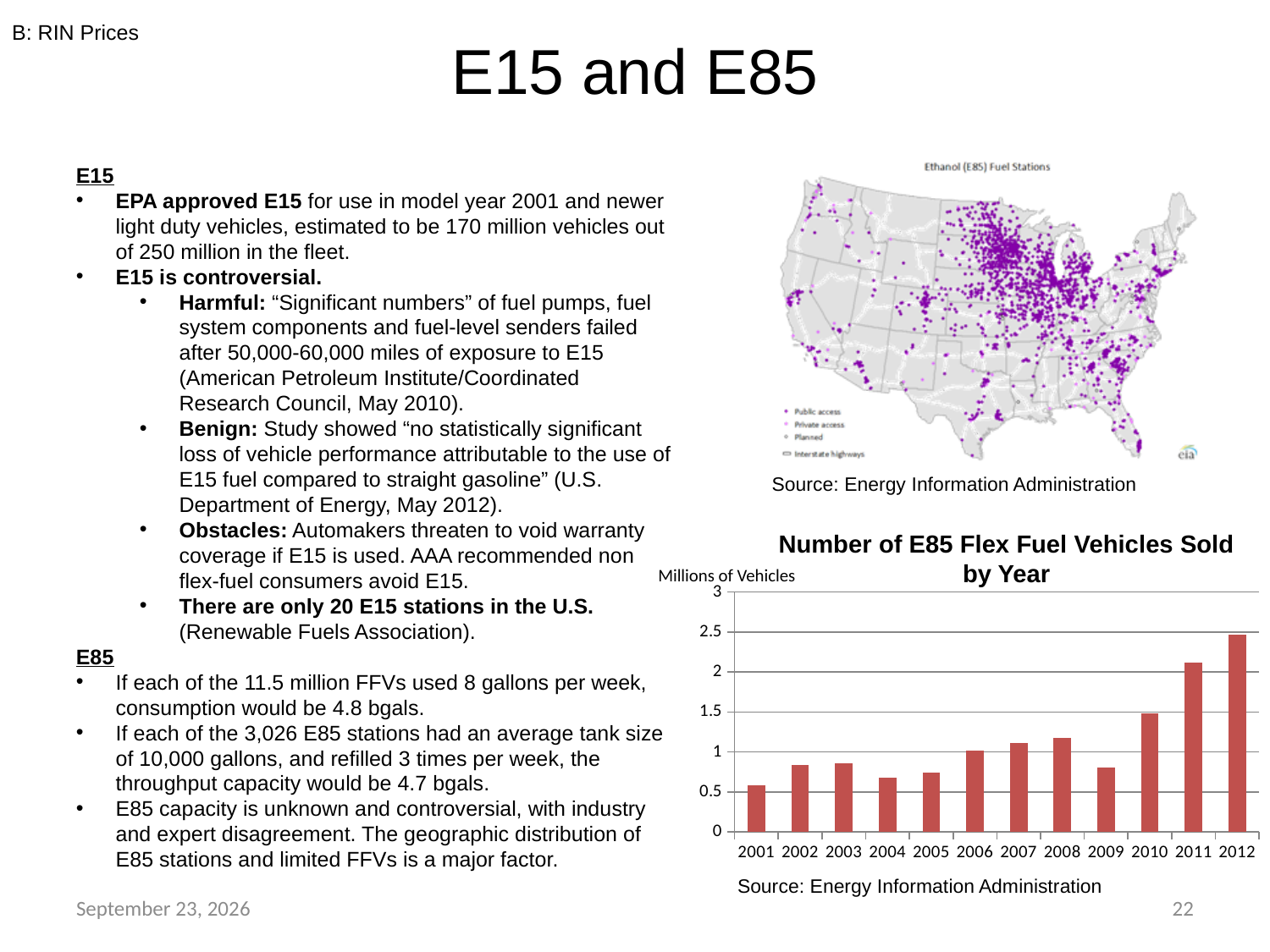
In the 'Number of E85 Flex Fuel Vehicles Sold by Year' chart, do the values generally rise or fall from 2009 to 2012? rise In the 'Number of E85 Flex Fuel Vehicles Sold by Year' chart, which year has the larger value, 2008 or 2009? 2008 In the 'Number of E85 Flex Fuel Vehicles Sold by Year' chart, which year has the lowest value? 2001 In the 'Number of E85 Flex Fuel Vehicles Sold by Year' chart, is the value for 2010 greater or less than 1? greater In the 'Number of E85 Flex Fuel Vehicles Sold by Year' chart, is the value for 2012 greater or less than 2? greater What unit label is shown on the vertical axis of the 'Number of E85 Flex Fuel Vehicles Sold by Year' chart? Millions of Vehicles In the 'Number of E85 Flex Fuel Vehicles Sold by Year' chart, is the value for 2001 greater or less than 1? less How many years are shown on the x axis of the 'Number of E85 Flex Fuel Vehicles Sold by Year' chart? 12 In the 'Number of E85 Flex Fuel Vehicles Sold by Year' chart, which year has the highest value? 2012 In the 'Number of E85 Flex Fuel Vehicles Sold by Year' chart, which year has the larger value, 2010 or 2011? 2011 What type of chart is the 'Number of E85 Flex Fuel Vehicles Sold by Year' chart? bar chart